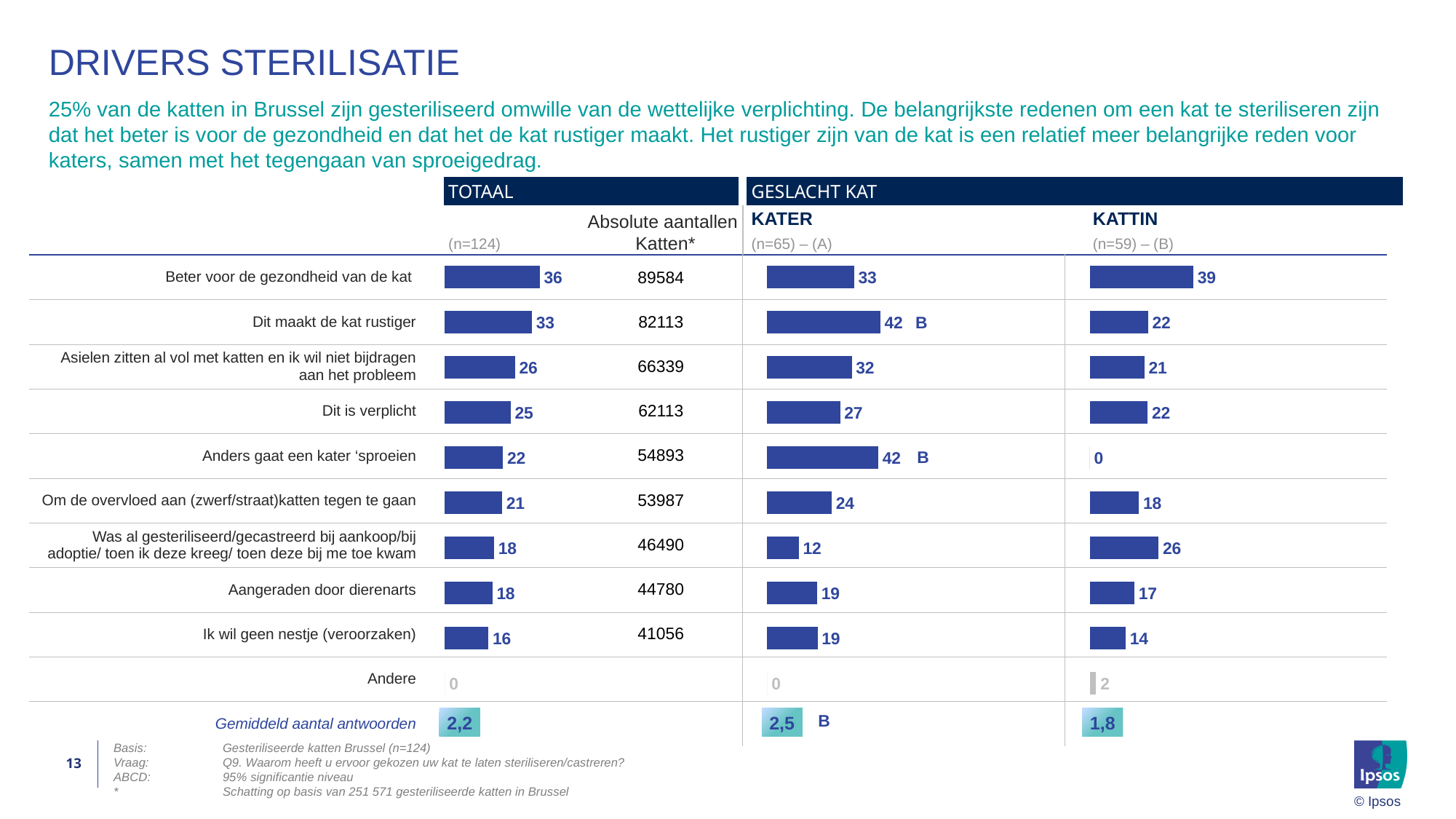
What is the 'Absolute aantallen Katten' value for 'Dit is verplicht'? 62113 How many categories (reasons) are listed in the TOTAAL chart? 10 In the TOTAAL chart, which category has the highest value? Beter voor de gezondheid van de kat What is the 'Gemiddeld aantal antwoorden' shown for KATER? 2,5 In the KATTIN chart, which category has the lowest value? Anders gaat een kater 'sproeien In the KATER chart, what is the value for 'Was al gesteriliseerd/gecastreerd bij aankoop/bij adoptie/ toen ik deze kreeg/ toen deze bij me toe kwam'? 12 For 'Anders gaat een kater 'sproeien', which chart shows the larger value, KATER or KATTIN? KATER What kind of chart is used in the TOTAAL column? Bar chart For 'Dit maakt de kat rustiger', what is the difference between the KATER value and the KATTIN value? 20 In the TOTAAL chart, what is the difference between 'Beter voor de gezondheid van de kat' and 'Dit maakt de kat rustiger'? 3 In the TOTAAL chart, what is the value for 'Dit is verplicht'? 25 In the KATTIN chart, what is the value for 'Beter voor de gezondheid van de kat'? 39